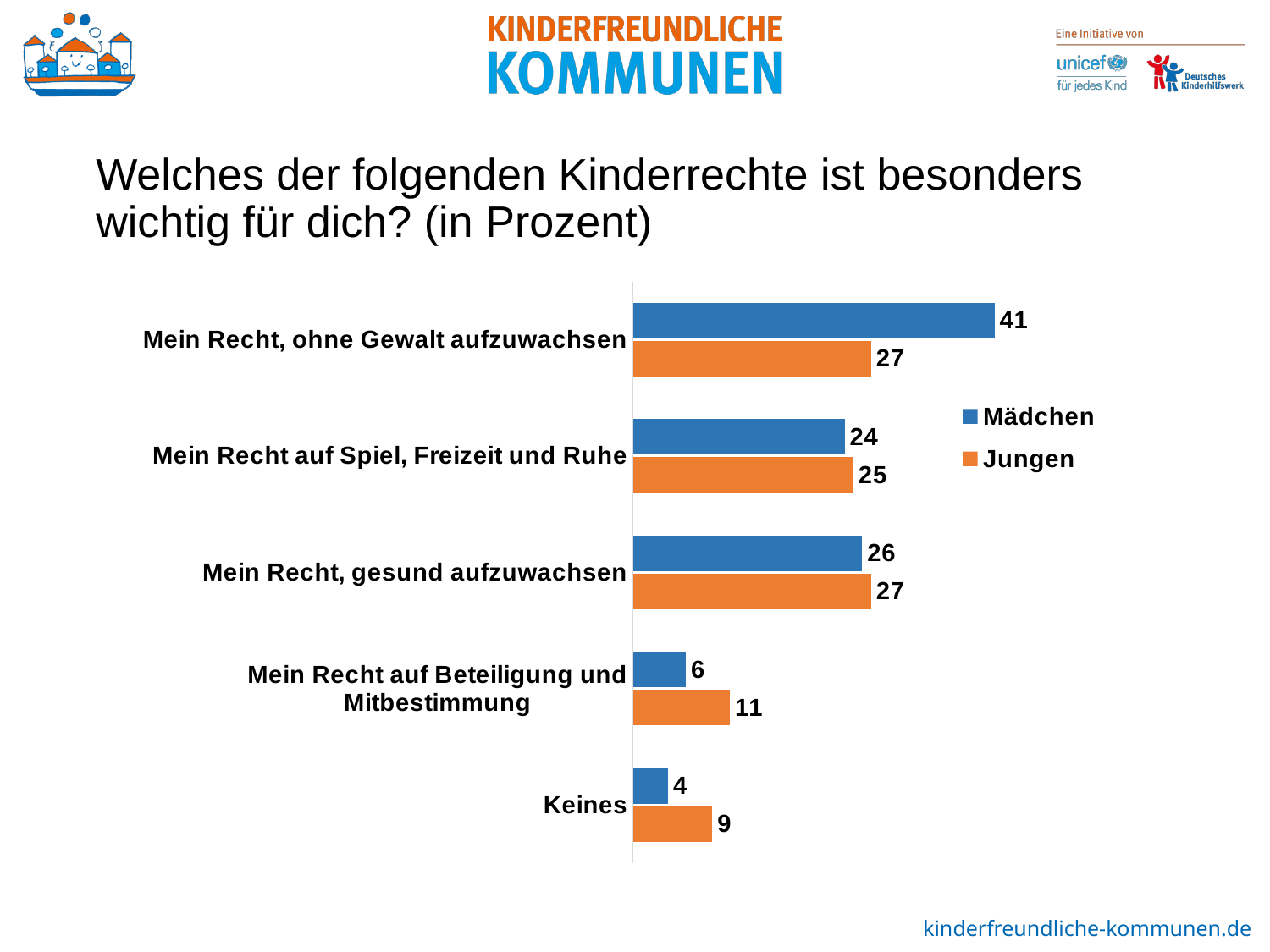
What is the value for Mädchen for "Mein Recht, ohne Gewalt aufzuwachsen"? 41 What is the value for Jungen for "Keines"? 9 For "Mein Recht, gesund aufzuwachsen", which is larger: the Mädchen value or the Jungen value? Jungen Which category has the lowest value for Jungen? Keines Which colour represents Jungen in the chart? Orange How many categories are shown in the chart? 5 How many series does the legend list? 2 What is the difference between the Mädchen and Jungen values for "Mein Recht, ohne Gewalt aufzuwachsen"? 14 Which category has the highest value for Mädchen? Mein Recht, ohne Gewalt aufzuwachsen What is the value for Jungen for "Mein Recht auf Beteiligung und Mitbestimmung"? 11 What kind of chart is shown on the slide? Bar chart What is the difference between the Jungen and Mädchen values for "Mein Recht auf Beteiligung und Mitbestimmung"? 5